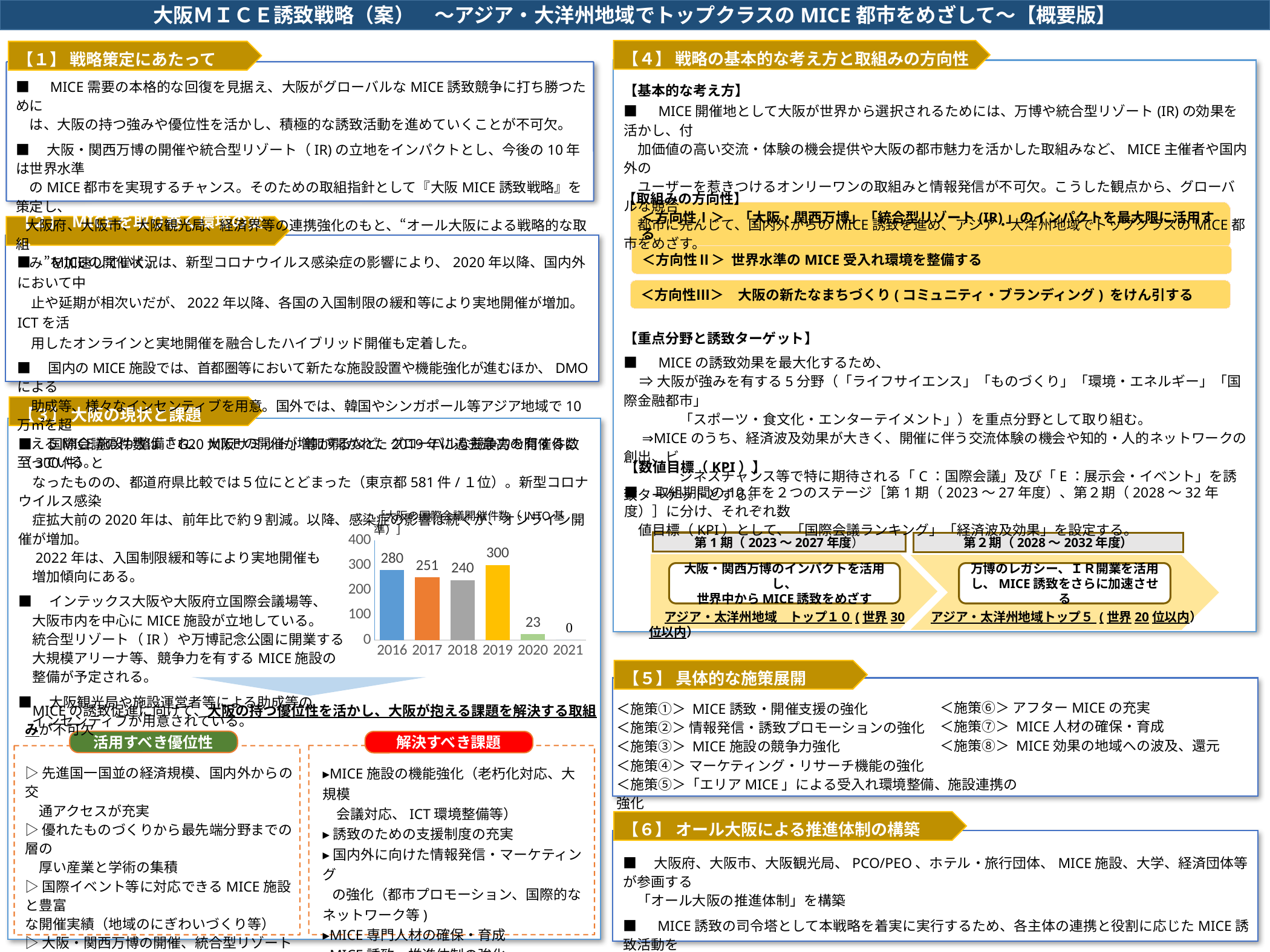
Do the values in the bar chart rise or fall from 2019 to 2021? fall Which year has the highest value in the bar chart? 2019 What is the value for 2020 in the bar chart? 23 What is the value for 2019 in the bar chart? 300 What type of chart is shown on the slide? bar chart What is the difference between the values for 2019 and 2020 in the bar chart? 277 Which year has the lowest value in the bar chart? 2021 What is the value for 2016 in the bar chart? 280 What is the difference between the values for 2016 and 2017 in the bar chart? 29 What is the value for 2021 in the bar chart? 0 How many years are shown on the x axis of the bar chart? 6 Which is larger in the bar chart, the value for 2017 or the value for 2018? 2017